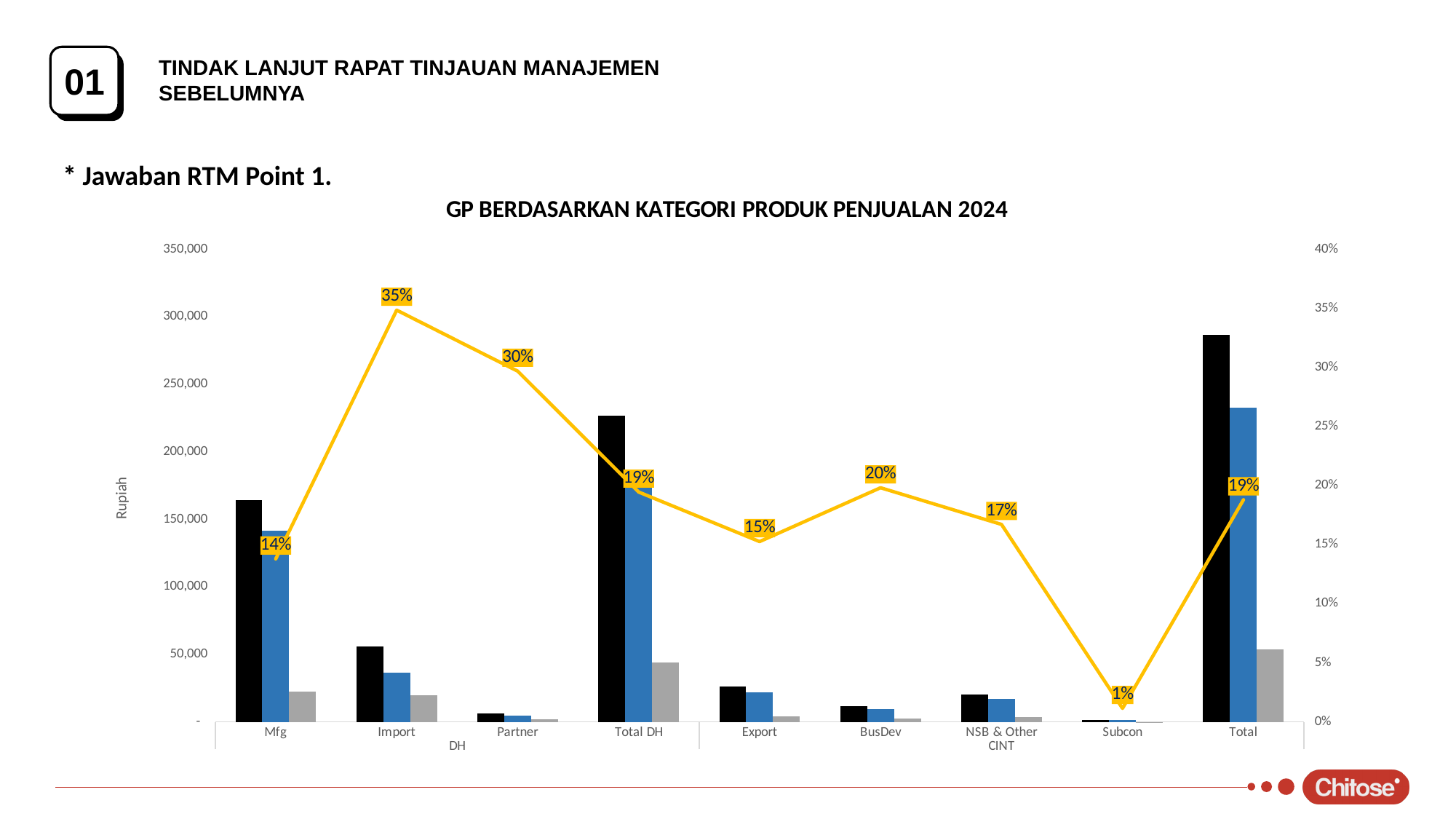
How many categories are shown on the x axis? 9 Which category has the lowest percentage on the line? Subcon What percentage does the line show for Import? 35% Is the black bar for Total greater or less than 250,000? greater Which has a higher line percentage, Export or BusDev? BusDev What is the title of the chart? GP BERDASARKAN KATEGORI PRODUK PENJUALAN 2024 What kind of chart is this? Combined bar and line chart What percentage does the line show for Subcon? 1% What percentage does the line show for NSB & Other CINT? 17% Which category has the highest percentage on the line? Import What is the difference between the line percentages for Import and Partner? 5% Is the black bar for Mfg greater or less than 150,000? greater